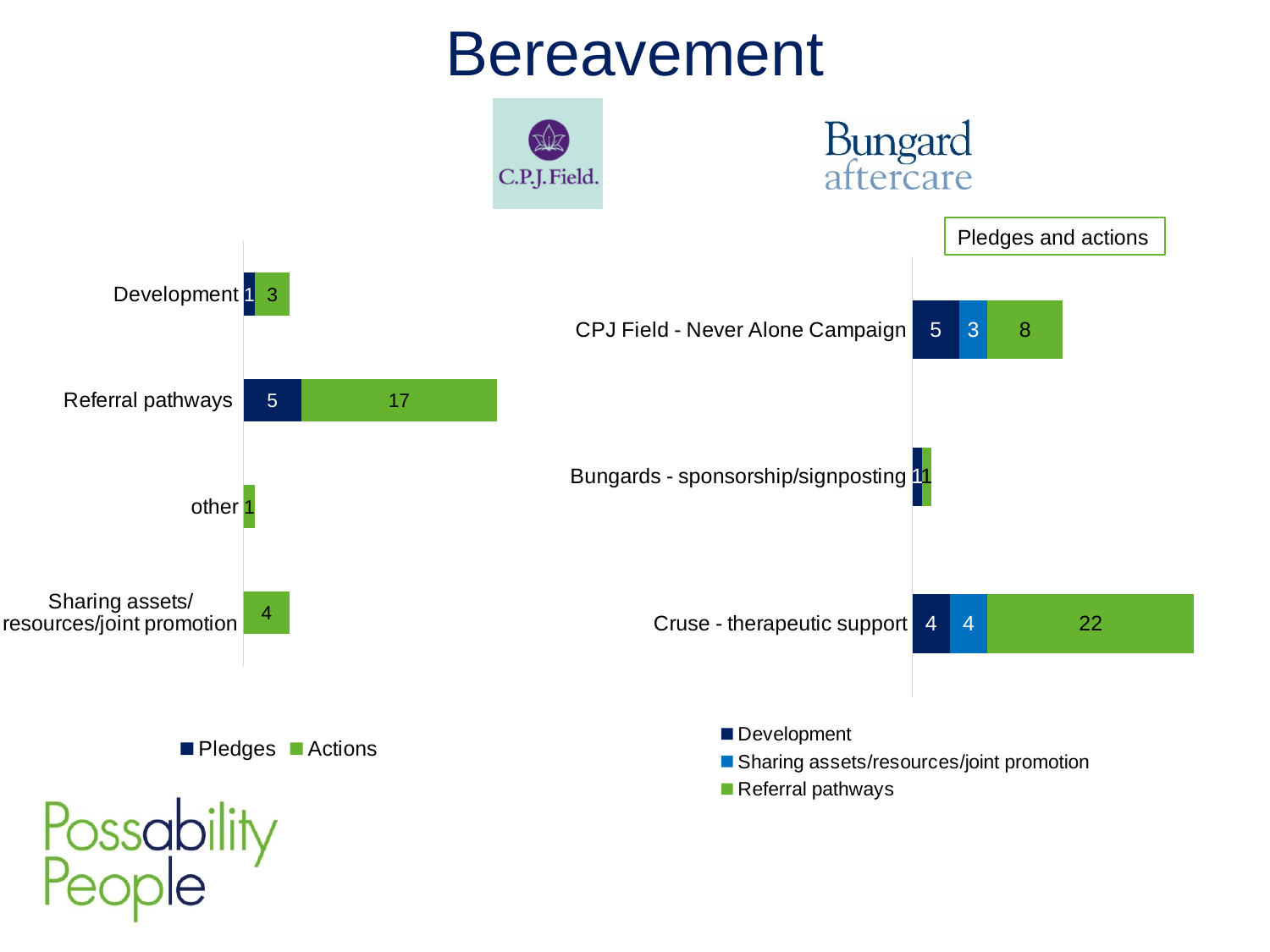
In the 'Pledges and actions' chart, how many categories are shown? 3 In the left chart, what is the Actions value for Referral pathways? 17 In the left chart, how many series does the legend list? 2 What kind of chart is the 'Pledges and actions' chart? Stacked bar chart In the 'Pledges and actions' chart, what is the Referral pathways value for Cruse - therapeutic support? 22 In the left chart, what is the difference between the Actions values for Referral pathways and Sharing assets/resources/joint promotion? 13 In the left chart, what is the total of the stacked bar for Referral pathways? 22 In the left chart, what is the Pledges value for Development? 1 In the left chart, which category has the highest Actions value? Referral pathways In the 'Pledges and actions' chart, what is the Development value for CPJ Field - Never Alone Campaign? 5 In the 'Pledges and actions' chart, what is the total of the stacked bar for CPJ Field - Never Alone Campaign? 16 In the 'Pledges and actions' chart, which category has the longest bar overall? Cruse - therapeutic support